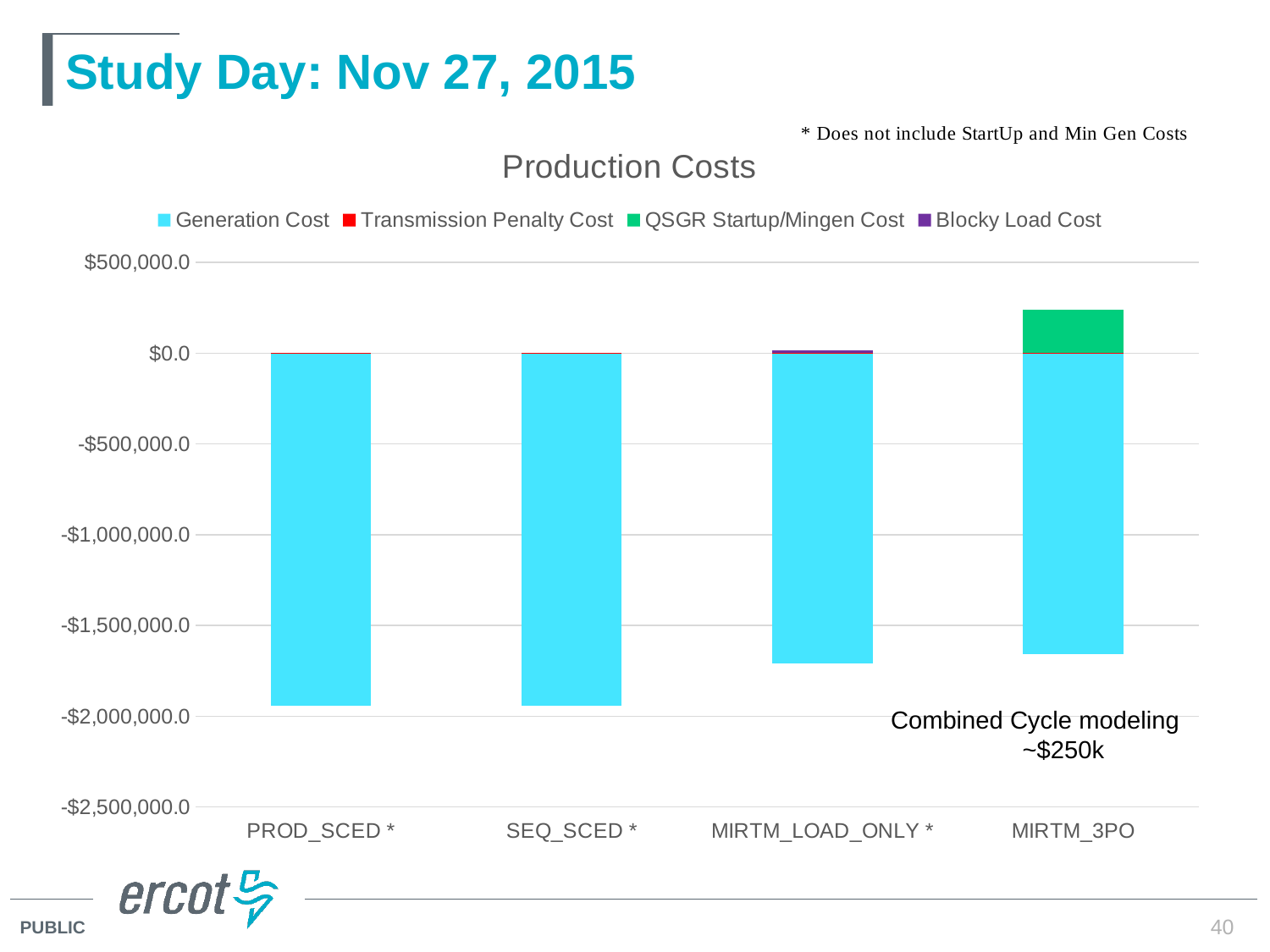
Which series is shown in green in the legend? QSGR Startup/Mingen Cost Is the Generation Cost for PROD_SCED * greater or less than -$1,500,000.0? less Is the Generation Cost for SEQ_SCED * greater or less than -$1,500,000.0? less How many categories are shown on the x axis? 4 Is the Generation Cost for MIRTM_3PO greater or less than -$1,500,000.0? less Which has the more negative Generation Cost, PROD_SCED * or MIRTM_LOAD_ONLY *? PROD_SCED * How many series does the legend list? 4 What kind of chart is shown on the slide? Stacked bar chart What is the title of the chart? Production Costs Which category is the only one with a visible QSGR Startup/Mingen Cost segment? MIRTM_3PO